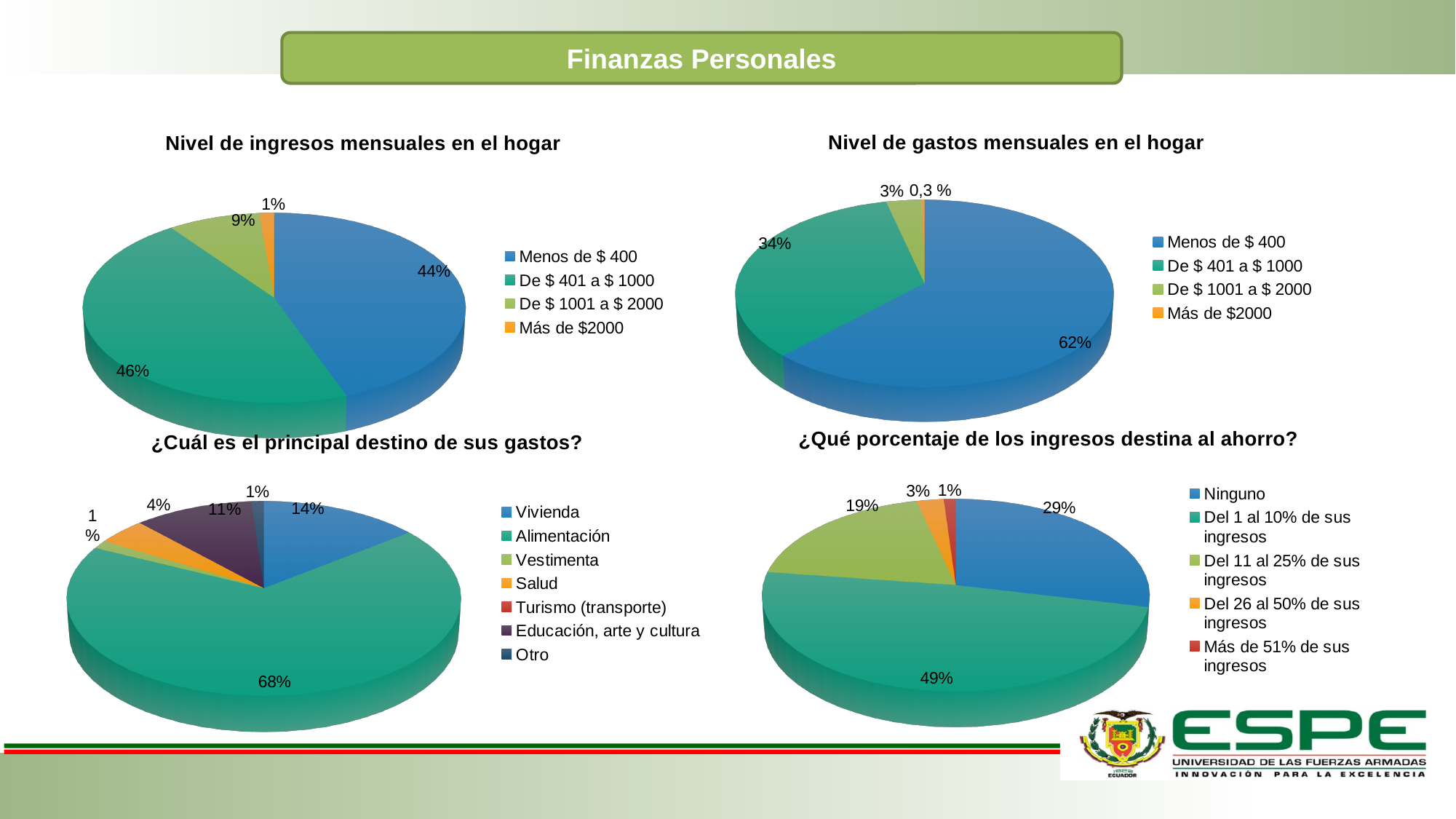
How many categories does the legend of the chart 'Nivel de gastos mensuales en el hogar' list? 4 In the chart 'Nivel de gastos mensuales en el hogar', what share is 'Menos de $ 400'? 62% In the chart 'Nivel de ingresos mensuales en el hogar', what share is 'De $ 401 a $ 1000'? 46% In the chart '¿Qué porcentaje de los ingresos destina al ahorro?', what share is 'Ninguno'? 29% In the chart 'Nivel de gastos mensuales en el hogar', which category has the largest share? Menos de $ 400 How many categories does the legend of the chart '¿Cuál es el principal destino de sus gastos?' list? 7 In the chart 'Nivel de ingresos mensuales en el hogar', what is the difference between 'De $ 401 a $ 1000' and 'Menos de $ 400'? 2% In the chart '¿Cuál es el principal destino de sus gastos?', what share is 'Alimentación'? 68% In the chart 'Nivel de gastos mensuales en el hogar', what share is 'Más de $2000'? 0,3 % In the chart '¿Cuál es el principal destino de sus gastos?', which is larger, 'Vivienda' or 'Educación, arte y cultura'? Vivienda What type of chart is '¿Qué porcentaje de los ingresos destina al ahorro?'? Pie chart In the chart 'Nivel de ingresos mensuales en el hogar', which category has the smallest share? Más de $2000